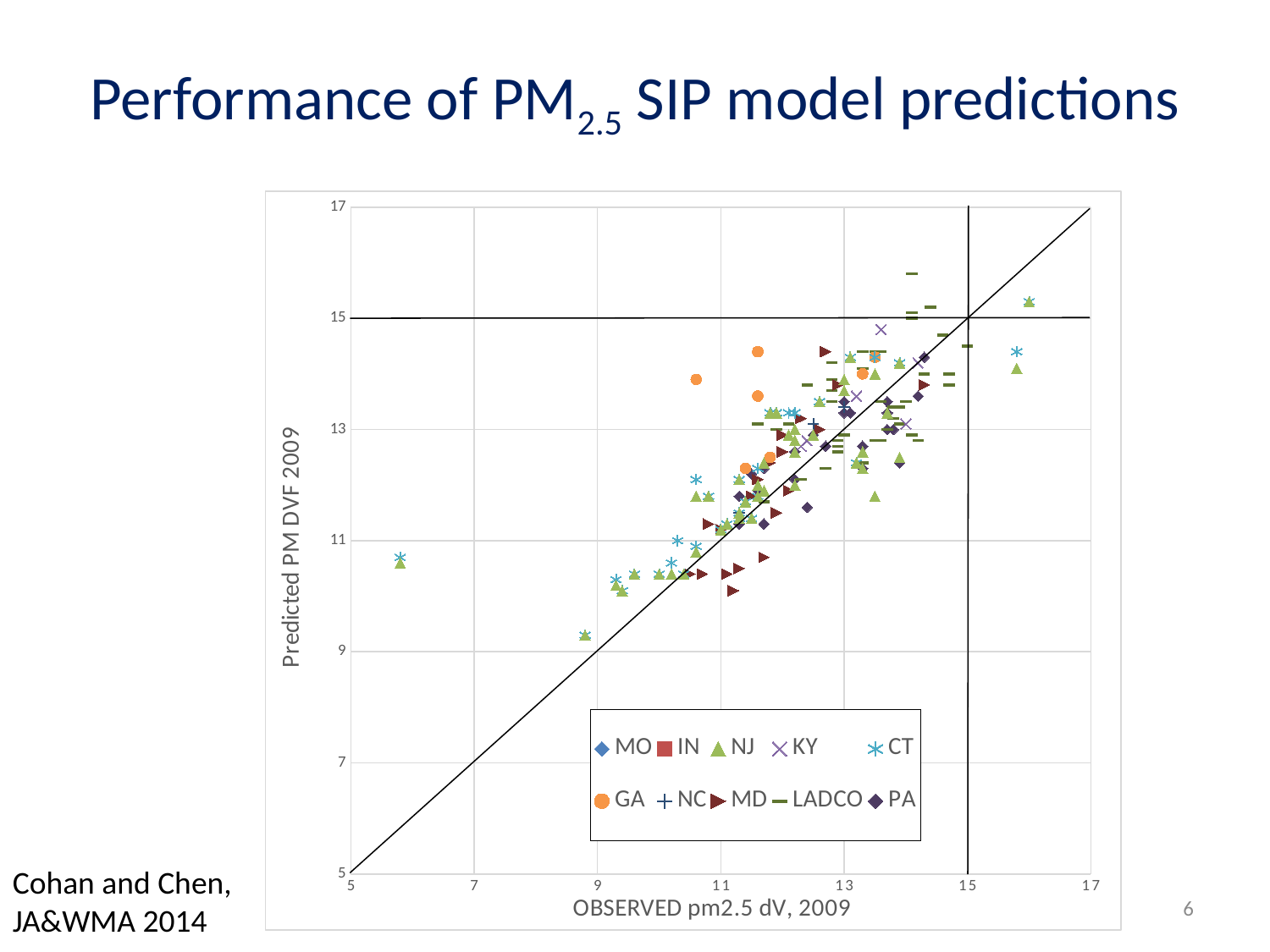
What is the maximum value shown on the y axis? 17 What is the title of the slide's chart? Performance of PM2.5 SIP model predictions Are the predicted values of all GA points greater or less than 12? greater What is the label of the y axis? Predicted PM DVF 2009 How many series does the chart legend list? 10 Is the predicted value of the highest LADCO point greater or less than 15? greater Do the predicted values generally rise or fall as the observed values increase along the x axis? Rise What kind of chart is shown on the slide? Scatter chart Is the predicted value of the leftmost point (near observed 5.8) greater or less than 11? less